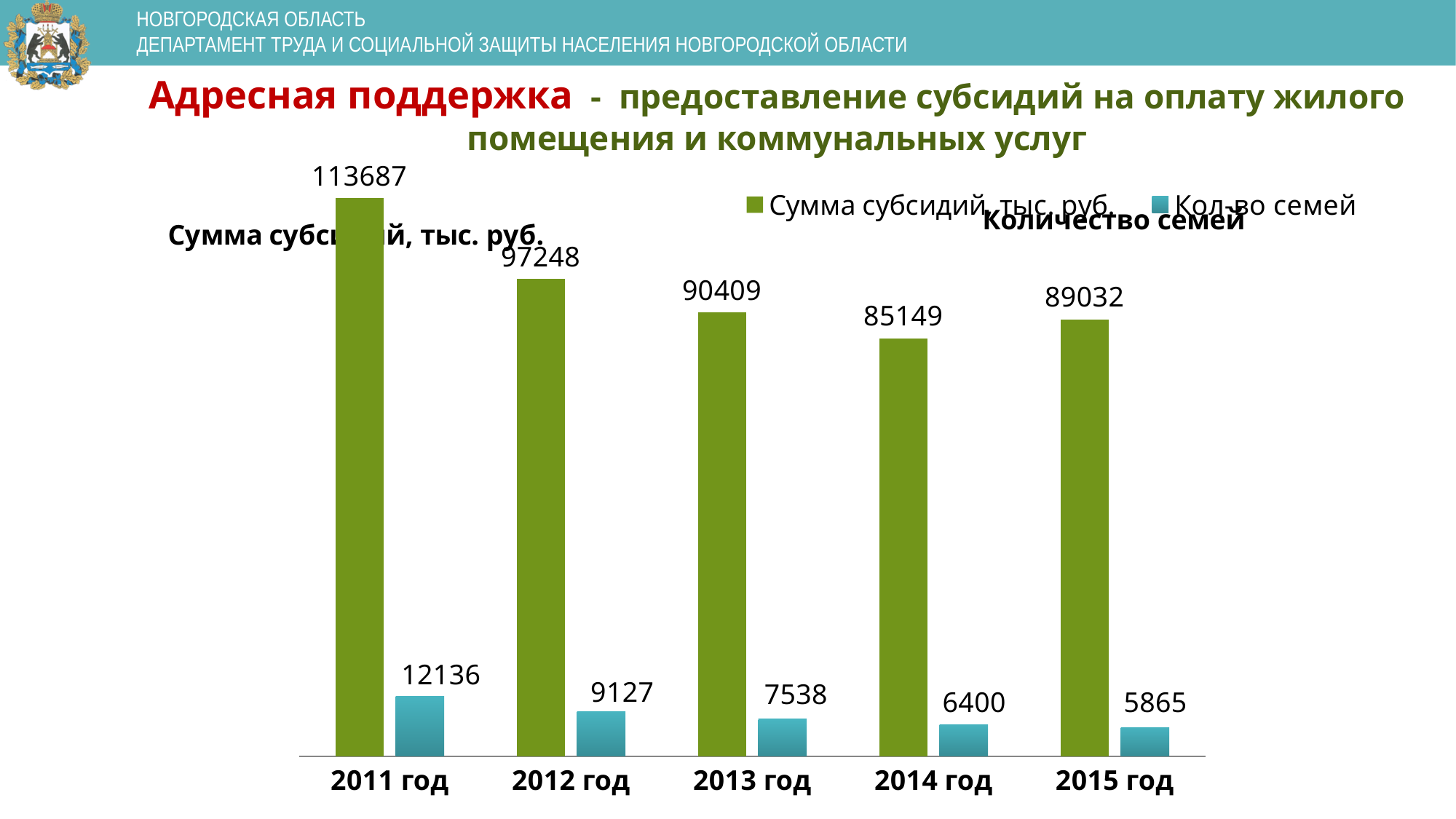
In which year is "Кол-во семей" the lowest? 2015 год What is the value of "Сумма субсидий, тыс. руб." for 2015 год? 89032 What is the difference in "Сумма субсидий, тыс. руб." between 2014 год and 2015 год? 3883 How many series does the chart legend list? 2 What is the value of "Сумма субсидий, тыс. руб." for 2011 год? 113687 In which year is "Сумма субсидий, тыс. руб." the lowest? 2014 год Does "Кол-во семей" rise or fall from 2011 год to 2015 год? fall What is the value of "Кол-во семей" for 2013 год? 7538 Which is larger: "Сумма субсидий, тыс. руб." in 2012 год or in 2013 год? 2012 год In which year is "Сумма субсидий, тыс. руб." the highest? 2011 год What is the difference in "Кол-во семей" between 2011 год and 2012 год? 3009 How many years are shown on the x axis of the chart? 5